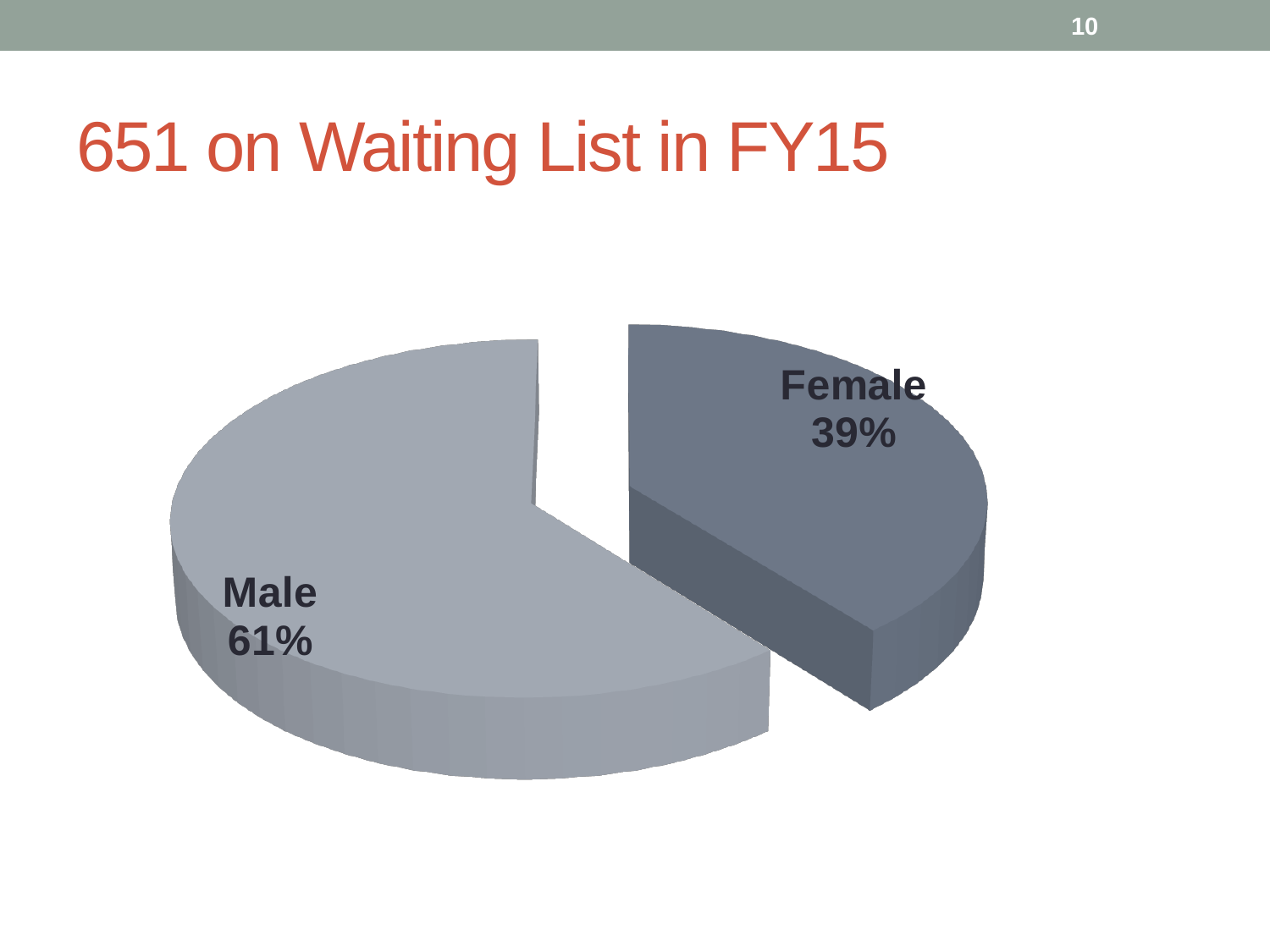
What share of the pie is Male? 61% How many slices does the pie chart have? 2 Which is larger, the Male slice or the Female slice? Male Is the Male share greater or less than 50%? greater What kind of chart is shown on the slide? Pie chart What is the difference in percentage points between the Male and Female slices? 22 What is the title of the slide? 651 on Waiting List in FY15 Which slice is the smallest? Female Which slice is the largest? Male Which slice is pulled out (exploded) from the pie? Female Is the Female share greater or less than 50%? less What share of the pie is Female? 39%